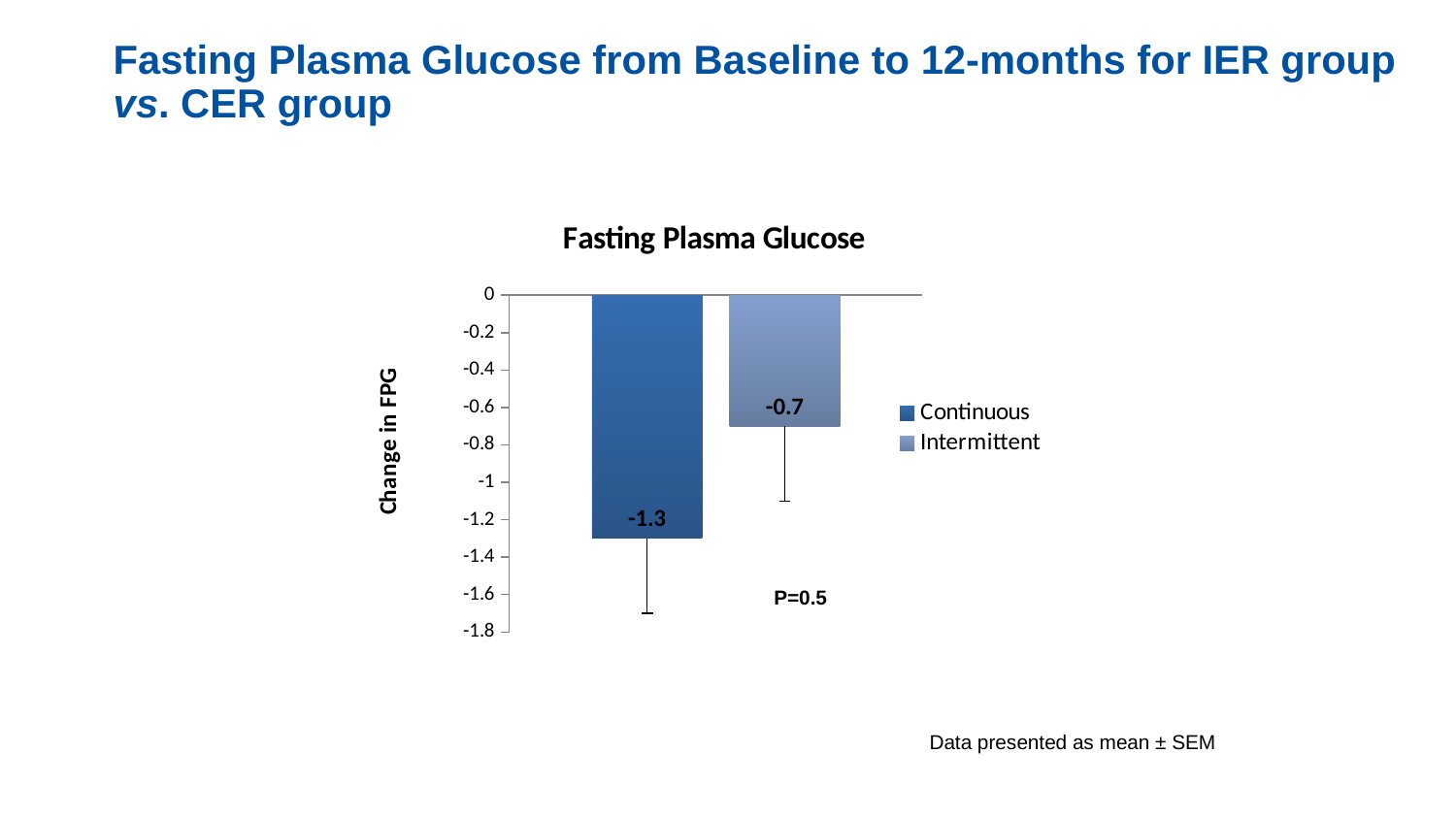
What is the difference between the Continuous and Intermittent values? 0.6 What is the value for Intermittent in the Fasting Plasma Glucose chart? -0.7 How many series does the legend list? 2 Is the value for Continuous greater or less than -1? less What is the value for Continuous in the Fasting Plasma Glucose chart? -1.3 Which series has the highest (least negative) value in the chart? Intermittent Which series shows the larger decrease in FPG, Continuous or Intermittent? Continuous What is the title of the chart? Fasting Plasma Glucose Is the value for Intermittent greater or less than -1? greater What kind of chart is shown on the slide? Bar chart Which series has the lowest (most negative) value in the chart? Continuous What is the label on the vertical axis of the chart? Change in FPG